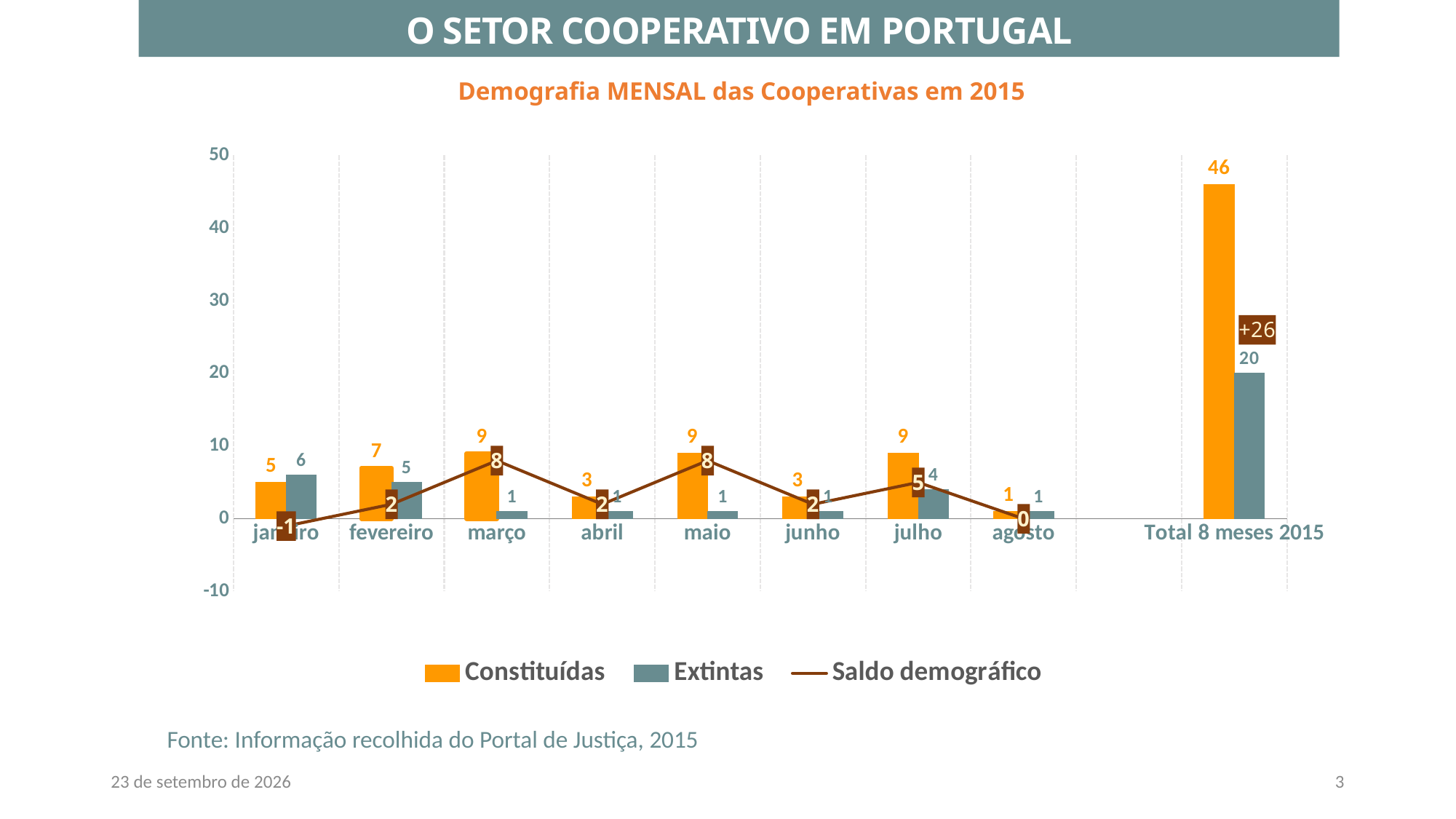
How many categories are shown on the x axis? 9 Which category has the highest Constituídas value? Total 8 meses 2015 What is the difference between Constituídas and Extintas for Total 8 meses 2015? 26 What kind of chart is shown on the slide? A bar chart combined with a line chart What is the Saldo demográfico value for Total 8 meses 2015? +26 What is the value of Extintas for julho? 4 How many series does the legend list? 3 Among the individual months (excluding the total), which month has the lowest Constituídas value? agosto Is the Constituídas value for Total 8 meses 2015 greater or less than 40? greater What is the Saldo demográfico value for janeiro? -1 What is the value of Constituídas for fevereiro? 7 In janeiro, which is larger: Constituídas or Extintas? Extintas